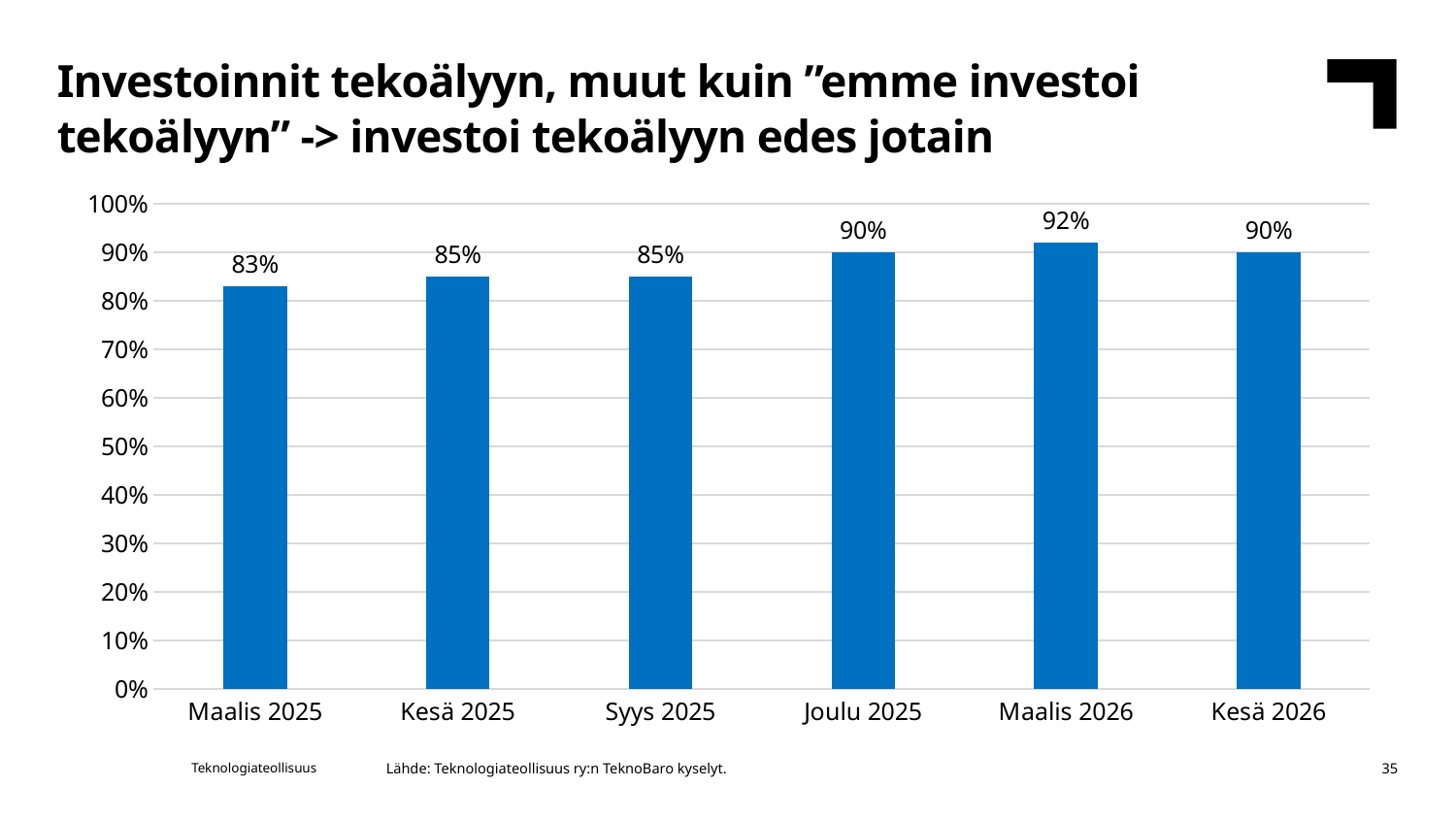
Which category has the lowest value? Maalis 2025 Do the values generally rise or fall from Maalis 2025 to Maalis 2026? rise Which category has the highest value? Maalis 2026 What is the difference between the values for Maalis 2026 and Maalis 2025? 9% Which is larger, the value for Kesä 2025 or the value for Joulu 2025? Joulu 2025 What is the value for Joulu 2025? 90% What is the value for Kesä 2026? 90% What is the value for Maalis 2025? 83% What is the source cited below the chart? Teknologiateollisuus ry:n TeknoBaro kyselyt What kind of chart is shown on the slide? bar chart How many categories are shown on the x axis? 6 Is the value for Syys 2025 greater or less than 80%? greater